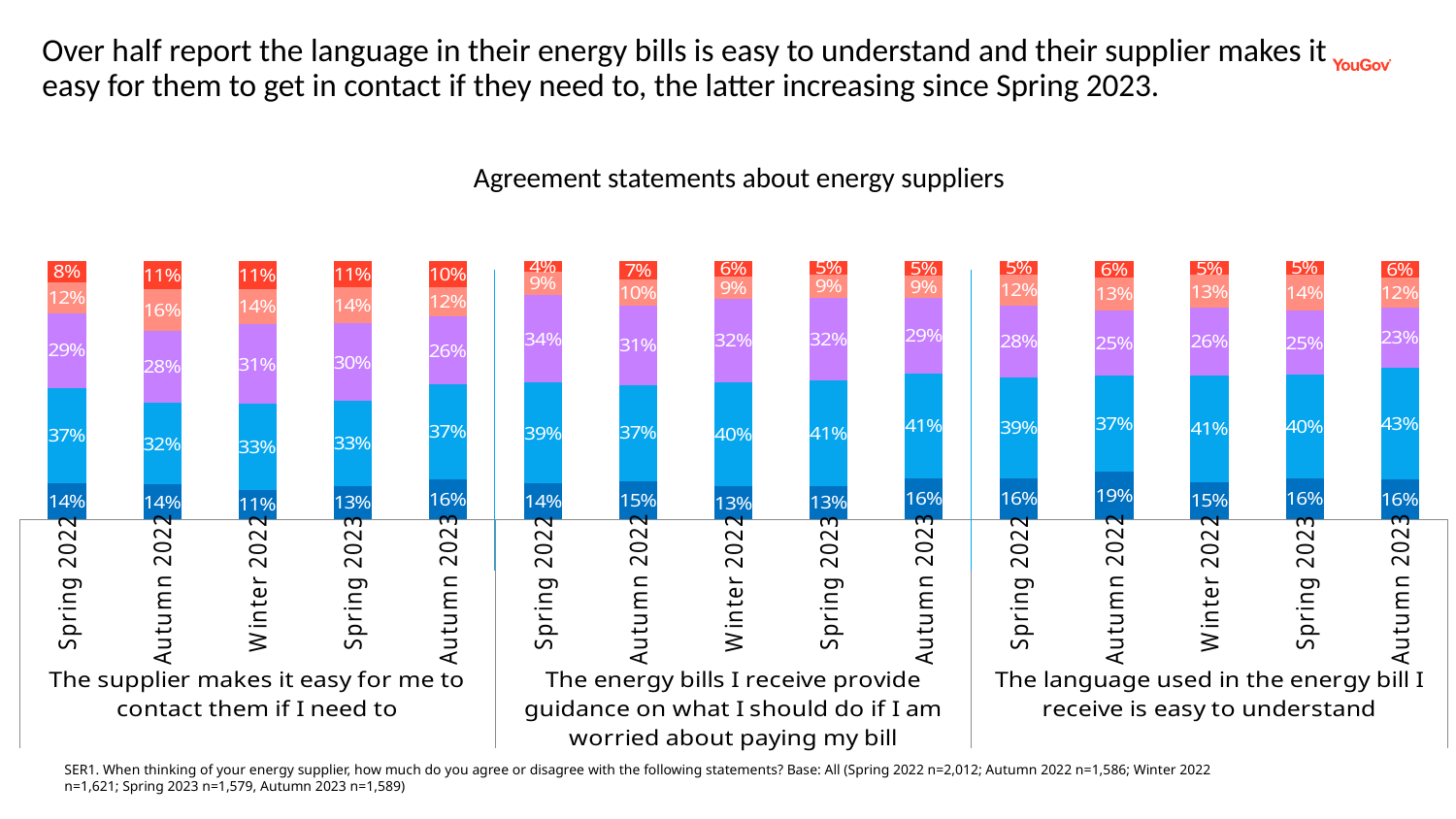
For the statement 'The language used in the energy bill I receive is easy to understand', what is the value of the light blue segment for Autumn 2023? 43% For the statement 'The supplier makes it easy for me to contact them if I need to', which period has the lowest value in the bottom dark blue segment? Winter 2022 What is the chart's title? Agreement statements about energy suppliers For the statement 'The language used in the energy bill I receive is easy to understand', which period has the highest value in the bottom dark blue segment? Autumn 2022 How many time periods are plotted for each statement? 5 For the statement 'The energy bills I receive provide guidance on what I should do if I am worried about paying my bill', is the purple segment larger in Spring 2022 or Autumn 2023? Spring 2022 For the statement 'The supplier makes it easy for me to contact them if I need to', what is the difference between the light blue segment values for Autumn 2023 and Autumn 2022? 5% For the statement 'The energy bills I receive provide guidance on what I should do if I am worried about paying my bill', what is the value of the top red segment for Spring 2022? 4% For the statement 'The supplier makes it easy for me to contact them if I need to', what is the value of the bottom dark blue segment for Autumn 2023? 16% What kind of chart is shown on the slide? Stacked bar chart For the statement 'The language used in the energy bill I receive is easy to understand', what is the total of the stacked bar for Autumn 2023? 100% For the statement 'The supplier makes it easy for me to contact them if I need to', what is the value of the purple segment for Winter 2022? 31%